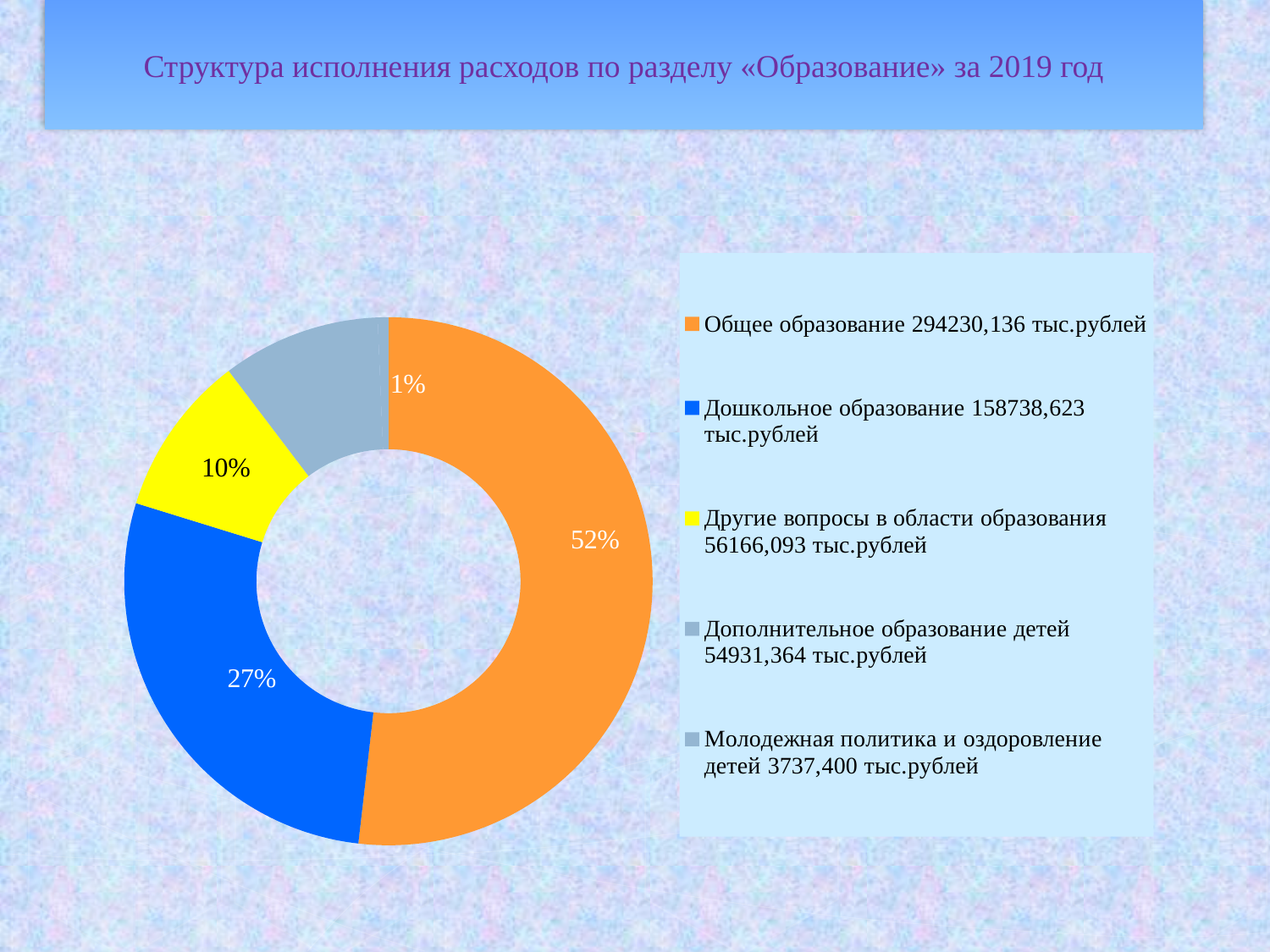
What percentage is shown for Другие вопросы в области образования? 10% What is the difference in percentage points between Общее образование and Дошкольное образование? 25% How many categories does the legend list? 5 What is the title of the slide? Структура исполнения расходов по разделу «Образование» за 2019 год What amount in тыс.рублей does the legend give for Общее образование? 294230,136 тыс.рублей Which category has the largest share of the chart? Общее образование Which is larger: the share for Дошкольное образование or for Другие вопросы в области образования? Дошкольное образование What amount in тыс.рублей does the legend give for Дополнительное образование детей? 54931,364 тыс.рублей Which category has the smallest amount according to the legend? Молодежная политика и оздоровление детей What share of the chart does Общее образование take? 52% What kind of chart is shown on the slide? Doughnut (pie) chart What percentage is shown for Дошкольное образование? 27%